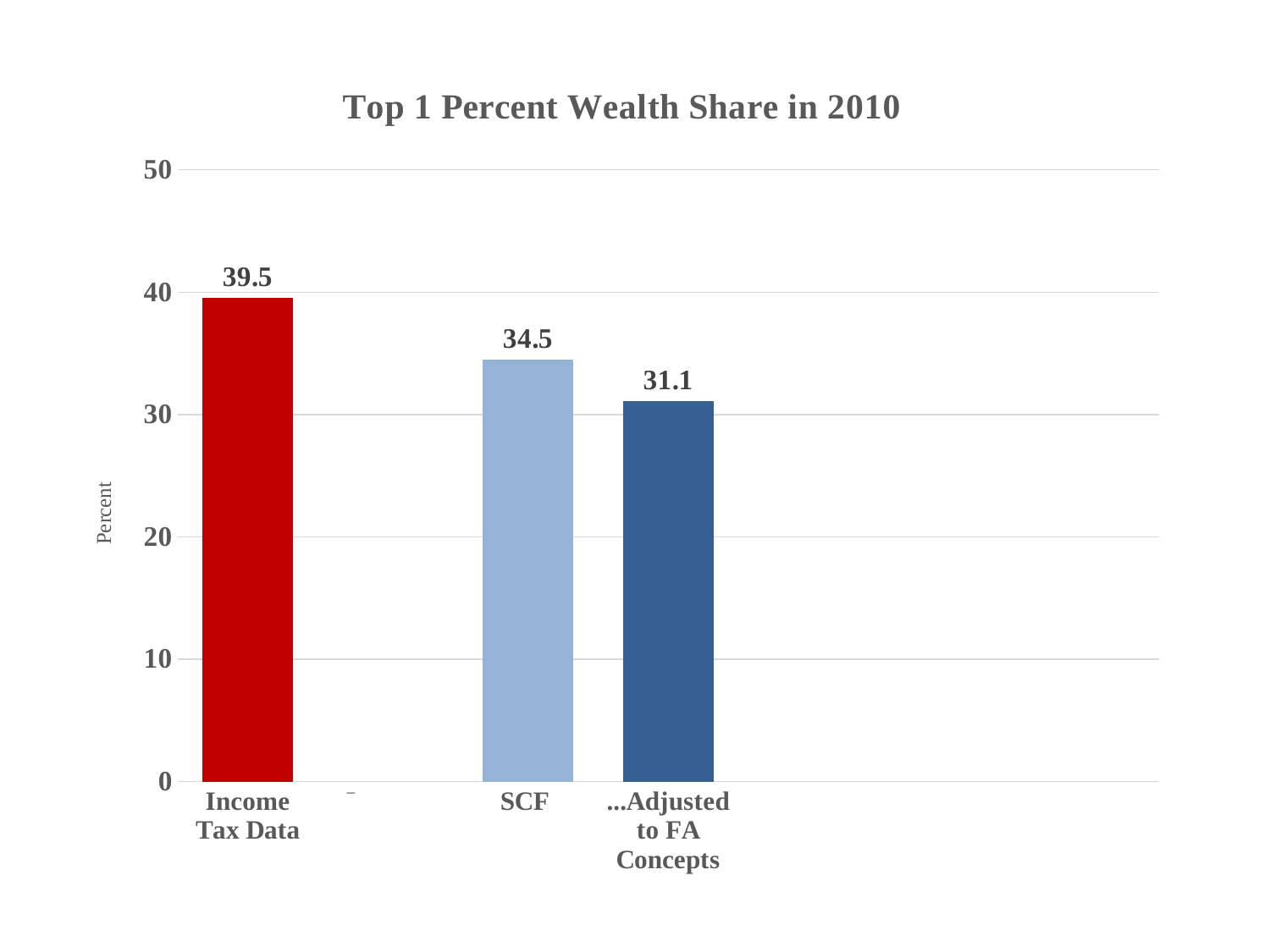
What is the value for SCF? 34.5 What is the difference between the values for SCF and ...Adjusted to FA Concepts? 3.4 What is the value for ...Adjusted to FA Concepts? 31.1 What is the value for Income Tax Data? 39.5 Which category has the highest value? Income Tax Data What kind of chart is shown on the slide? bar chart Which category has the lowest value? ...Adjusted to FA Concepts Which is larger, the value for SCF or the value for ...Adjusted to FA Concepts? SCF What is the difference between the values for Income Tax Data and SCF? 5.0 How many bars are plotted in the chart? 3 What is the title of the chart? Top 1 Percent Wealth Share in 2010 Is the value for Income Tax Data greater or less than 40? less